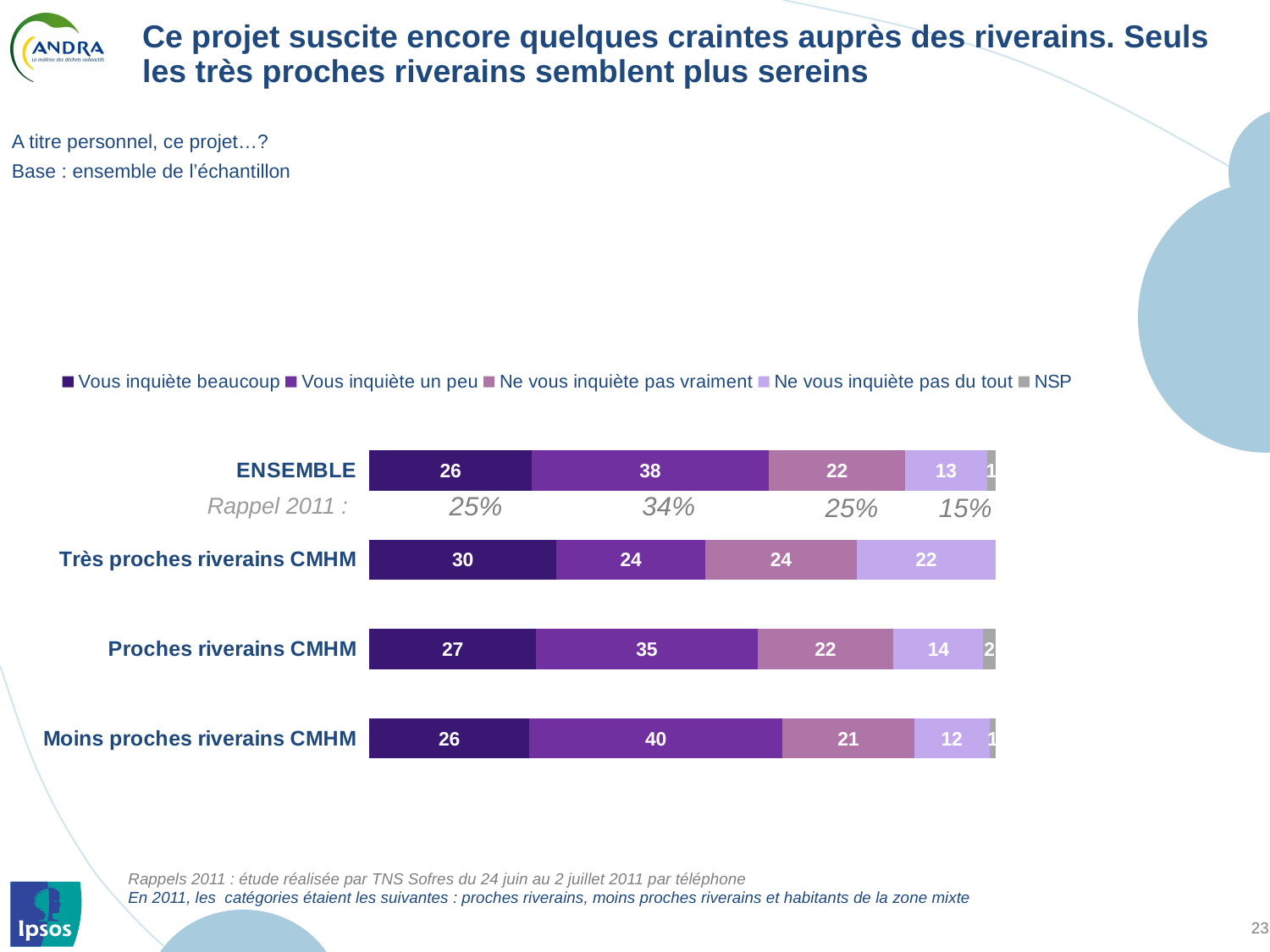
What is the value of "Vous inquiète un peu" for Moins proches riverains CMHM? 40 What was the "Vous inquiète un peu" value in the Rappel 2011 row? 34% What is the value of "Ne vous inquiète pas vraiment" for Proches riverains CMHM? 22 Which category has the highest value for "Vous inquiète beaucoup"? Très proches riverains CMHM What kind of chart is shown on the slide? Stacked bar chart How many series does the legend list? 5 What is the value of "Vous inquiète beaucoup" for Très proches riverains CMHM? 30 What is the value of "Ne vous inquiète pas du tout" for ENSEMBLE? 13 Which category has the lowest value for "Vous inquiète un peu"? Très proches riverains CMHM How many categories (bars) are plotted in the chart? 4 What is the difference between the "Ne vous inquiète pas du tout" values for Très proches riverains CMHM and Moins proches riverains CMHM? 10 Which is larger: "Vous inquiète un peu" for Proches riverains CMHM or for Moins proches riverains CMHM? Moins proches riverains CMHM